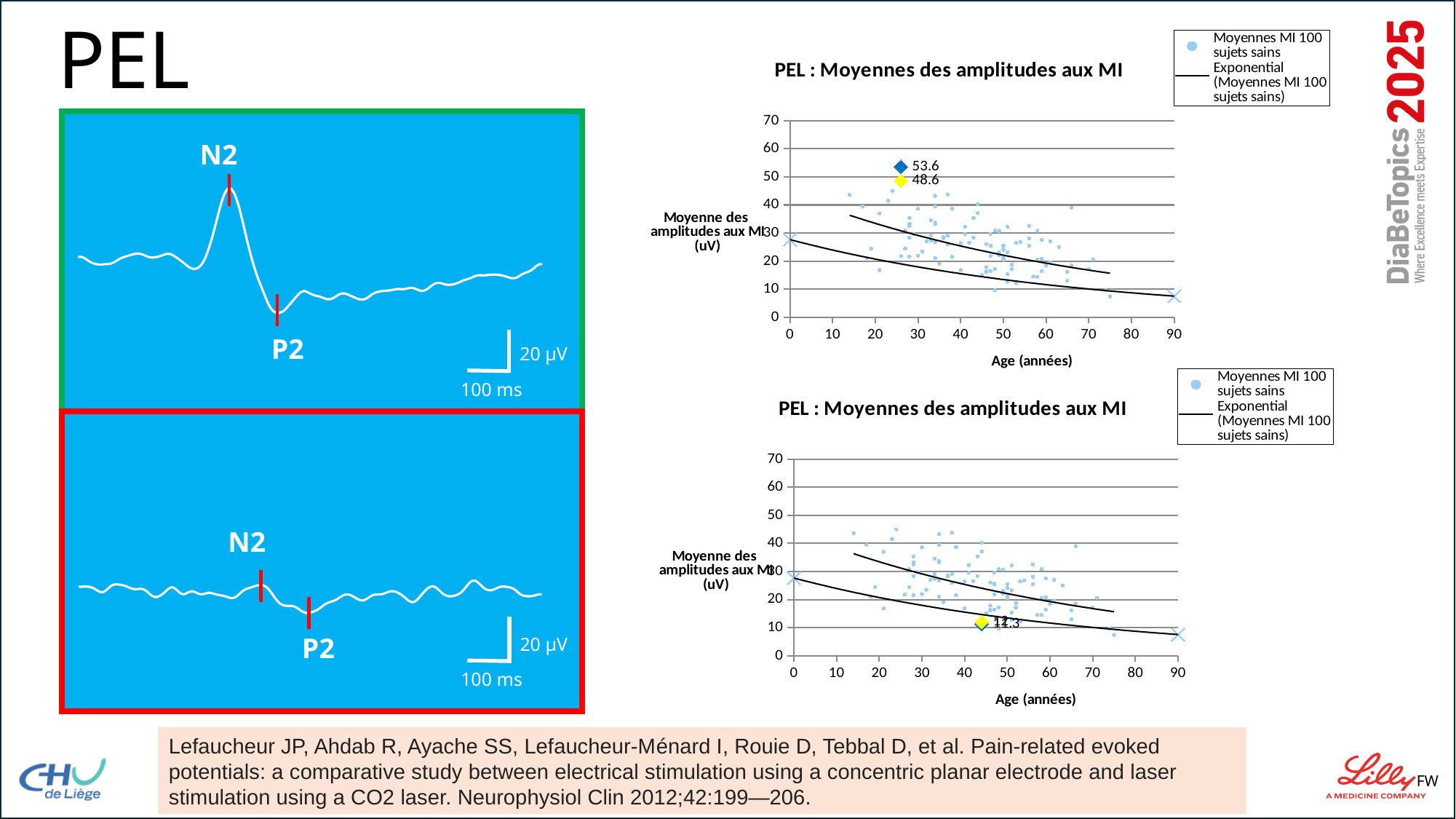
In the top chart, what value is labelled on the yellow diamond marker? 48.6 In the bottom chart, do the exponential trend lines rise or fall as age increases? fall In the bottom chart, is the labelled yellow diamond value greater or less than 20? less In the top chart, which labelled marker has the larger value, the dark blue diamond or the yellow diamond? the dark blue diamond (53.6) In the top chart, what value is labelled on the dark blue diamond marker? 53.6 What is the x-axis title of the bottom chart? Age (années) What is the highest tick value shown on the y-axis of the top chart? 70 How many entries does the legend of the top chart list? 2 What kind of chart is the top chart titled 'PEL : Moyennes des amplitudes aux MI'? scatter chart In the top chart, is the labelled dark blue diamond value greater or less than 50? greater In the top chart, what is the difference between the two labelled values 53.6 and 48.6? 5.0